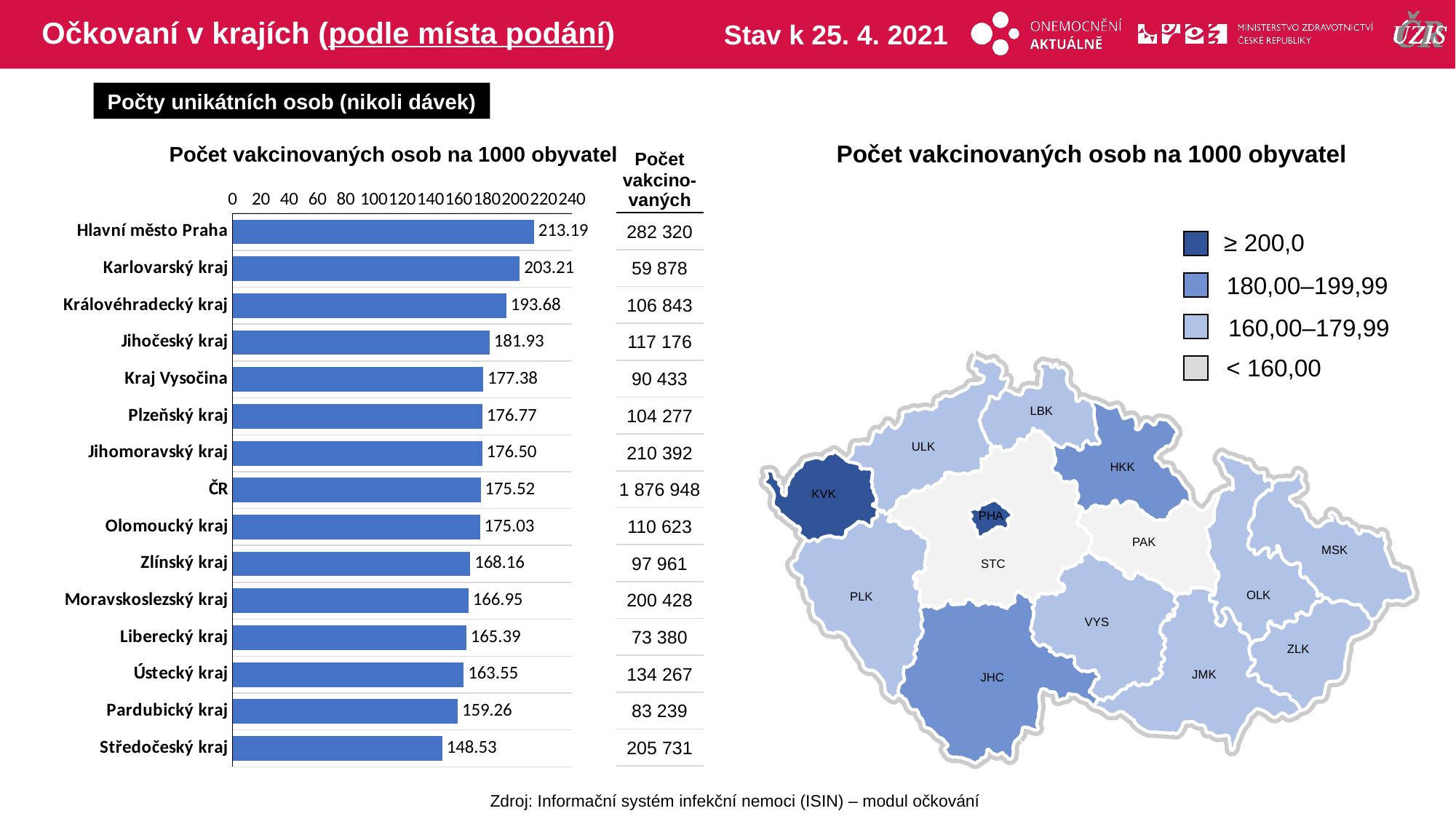
In the bar chart, which category has the highest value? Hlavní město Praha In the bar chart, which is larger: the value for Jihočeský kraj or the value for Zlínský kraj? Jihočeský kraj In the bar chart, what is the value for ČR? 175.52 How many bars does the bar chart show? 15 In the bar chart, is the value for Pardubický kraj greater or less than 160? less In the bar chart, what is the value for Hlavní město Praha? 213.19 In the bar chart, what is the value for Jihomoravský kraj? 176.50 In the bar chart, which category has the lowest value? Středočeský kraj In the bar chart, do the values rise or fall going from the top bar to the bottom bar? fall In the bar chart, what is the difference between the values for Karlovarský kraj and Královéhradecký kraj? 9.53 In the bar chart, what is the difference between the values for Hlavní město Praha and Středočeský kraj? 64.66 What kind of chart is used on the left side of the slide to show the number of vaccinated persons per 1000 inhabitants? bar chart